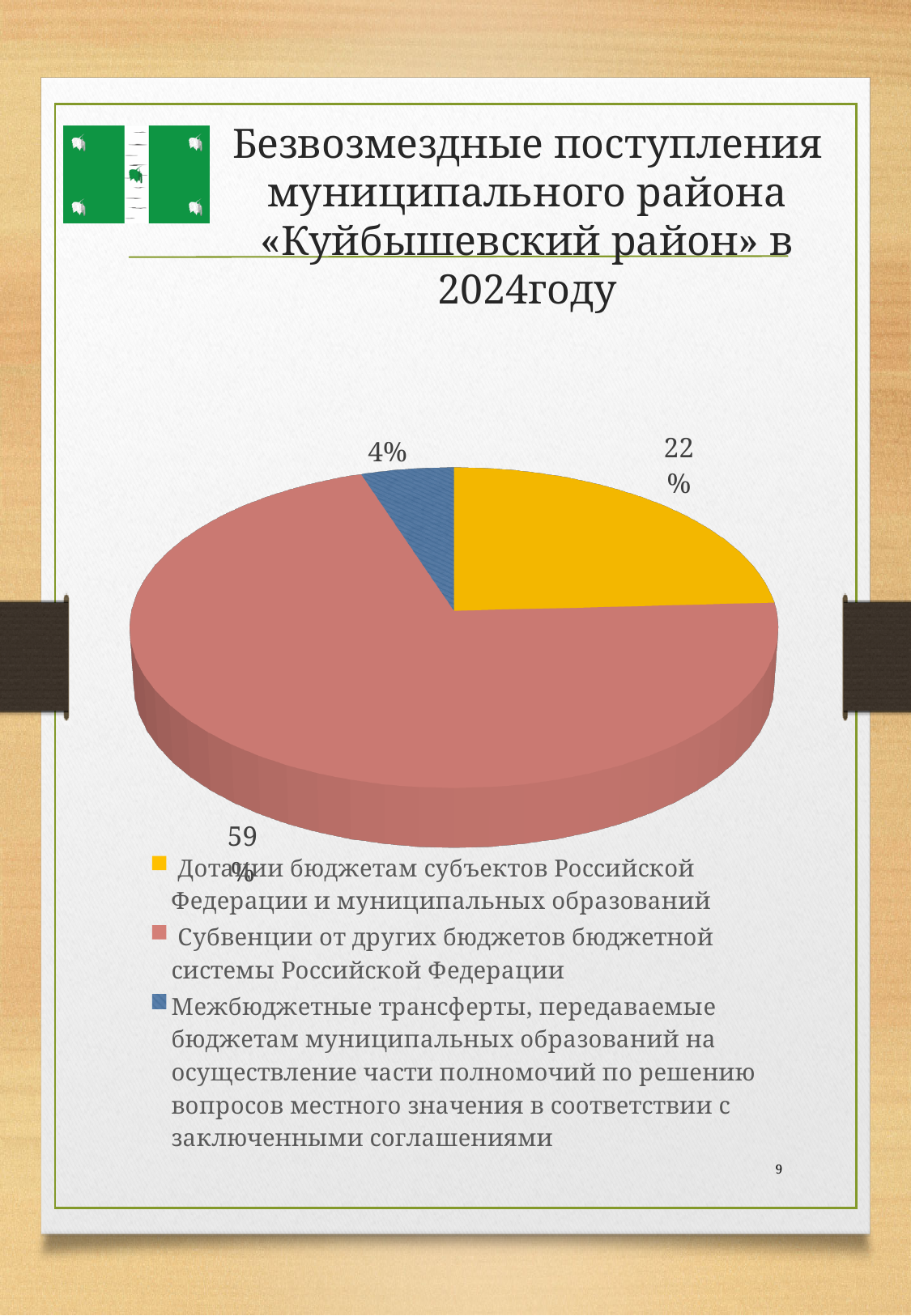
What year does the chart title refer to? 2024 What share of the pie is labelled for «Межбюджетные трансферты, передаваемые бюджетам муниципальных образований...»? 4% Which category has the smallest slice of the pie? Межбюджетные трансферты, передаваемые бюджетам муниципальных образований на осуществление части полномочий What kind of chart is shown on the slide? Pie chart How many slices does the pie chart have? 3 What colour is the slice for «Субвенции от других бюджетов бюджетной системы Российской Федерации»? Pink/red Which is larger: the «Дотации» slice or the «Межбюджетные трансферты» slice? Дотации What share of the pie is labelled for «Дотации бюджетам субъектов Российской Федерации и муниципальных образований»? 22% What share of the pie is labelled for «Субвенции от других бюджетов бюджетной системы Российской Федерации»? 59% Which category has the largest slice of the pie? Субвенции от других бюджетов бюджетной системы Российской Федерации How many entries does the legend list? 3 What is the difference in percentage points between the «Субвенции» slice and the «Дотации» slice? 37